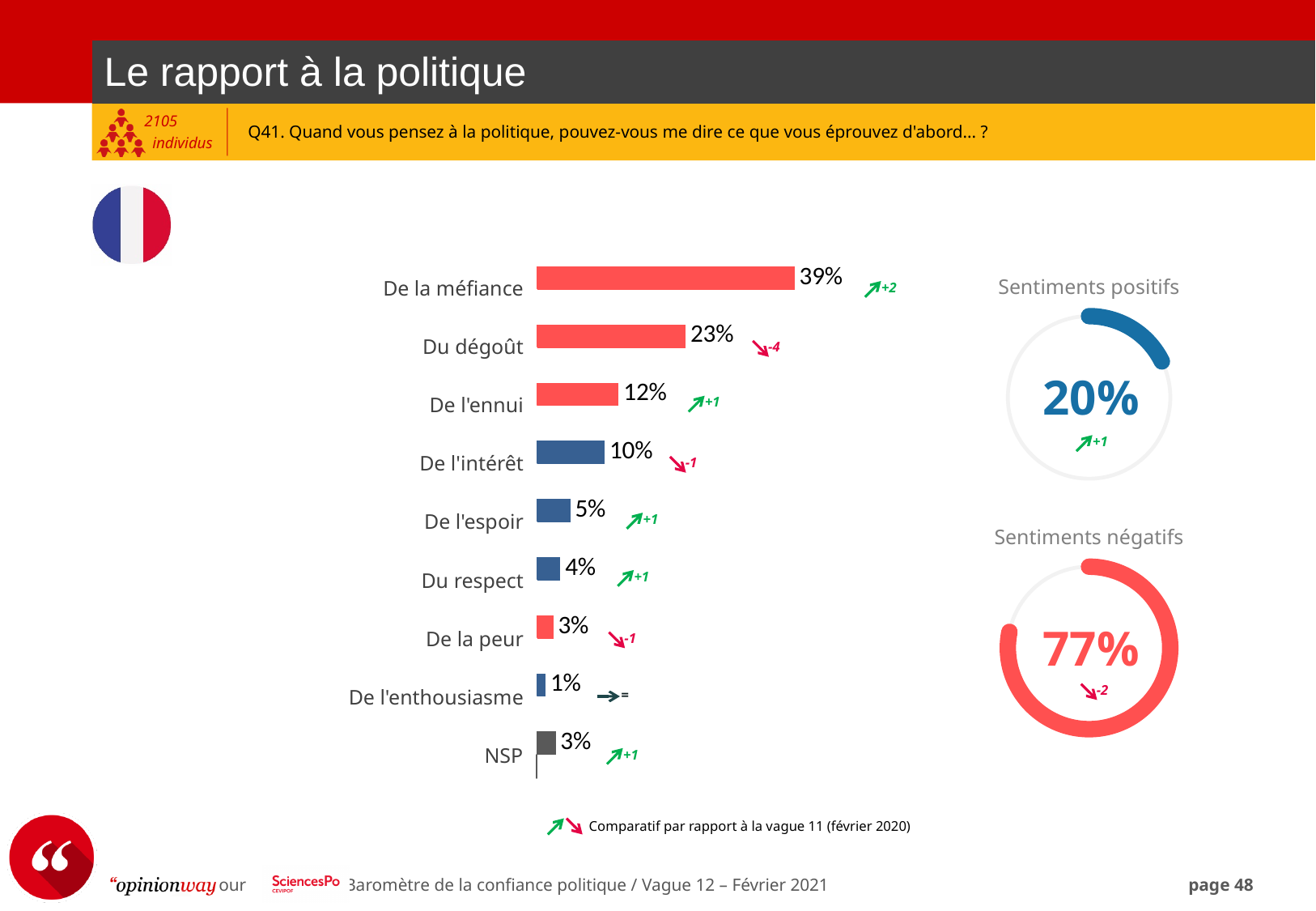
How many categories does the bar chart show? 9 In the bar chart, which category has the highest value? De la méfiance In the bar chart, which is larger, the value for "De l'ennui" or the value for "De l'intérêt"? De l'ennui In the "Sentiments positifs" donut chart, what value is shown? 20% In the bar chart, what is the value for "De l'intérêt"? 10% In the bar chart, which category has the lowest value? De l'enthousiasme What kind of chart is the main chart on the left of the slide? Bar chart In the bar chart, what is the value for "Du dégoût"? 23% In the bar chart, what is the value for "De l'espoir"? 5% In the bar chart, what is the difference between the values for "De la méfiance" and "Du dégoût"? 16% In the "Sentiments négatifs" donut chart, what value is shown? 77% In the bar chart, what is the value for "De la méfiance"? 39%